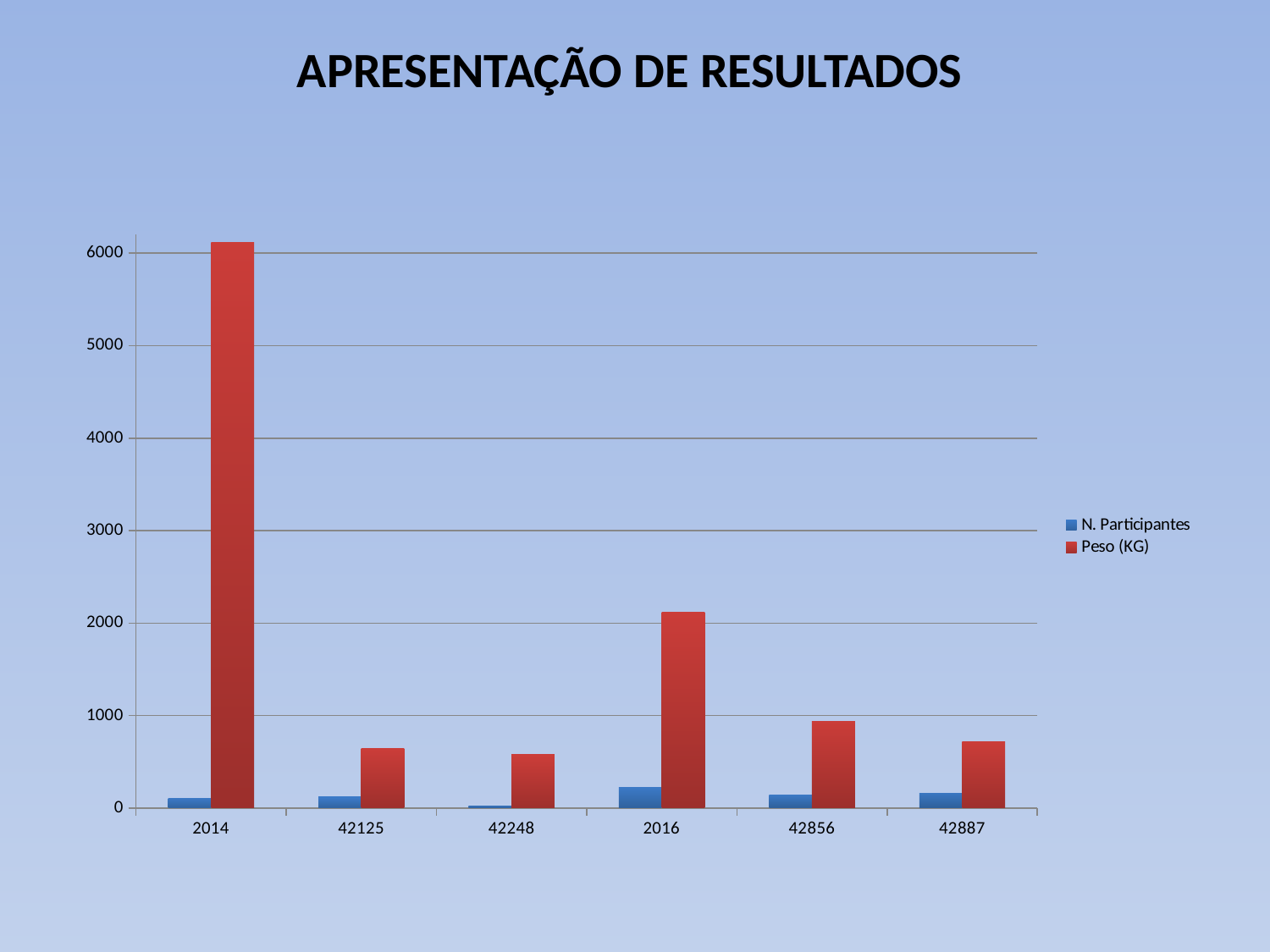
Which category has the highest value for N. Participantes? 2016 What is the title of the slide? APRESENTAÇÃO DE RESULTADOS How many series does the legend list? 2 Which series is shown in red? Peso (KG) How many categories are shown on the x axis? 6 Is the Peso (KG) value for 2014 greater or less than 6000? greater Is the Peso (KG) value for 2016 greater or less than 2000? greater Which category has the highest value for Peso (KG)? 2014 What kind of chart is shown on the slide? bar chart Which is larger, the Peso (KG) value for 2016 or for 42856? 2016 Which category has the lowest value for N. Participantes? 42248 Is the Peso (KG) value for 42856 greater or less than 1000? less